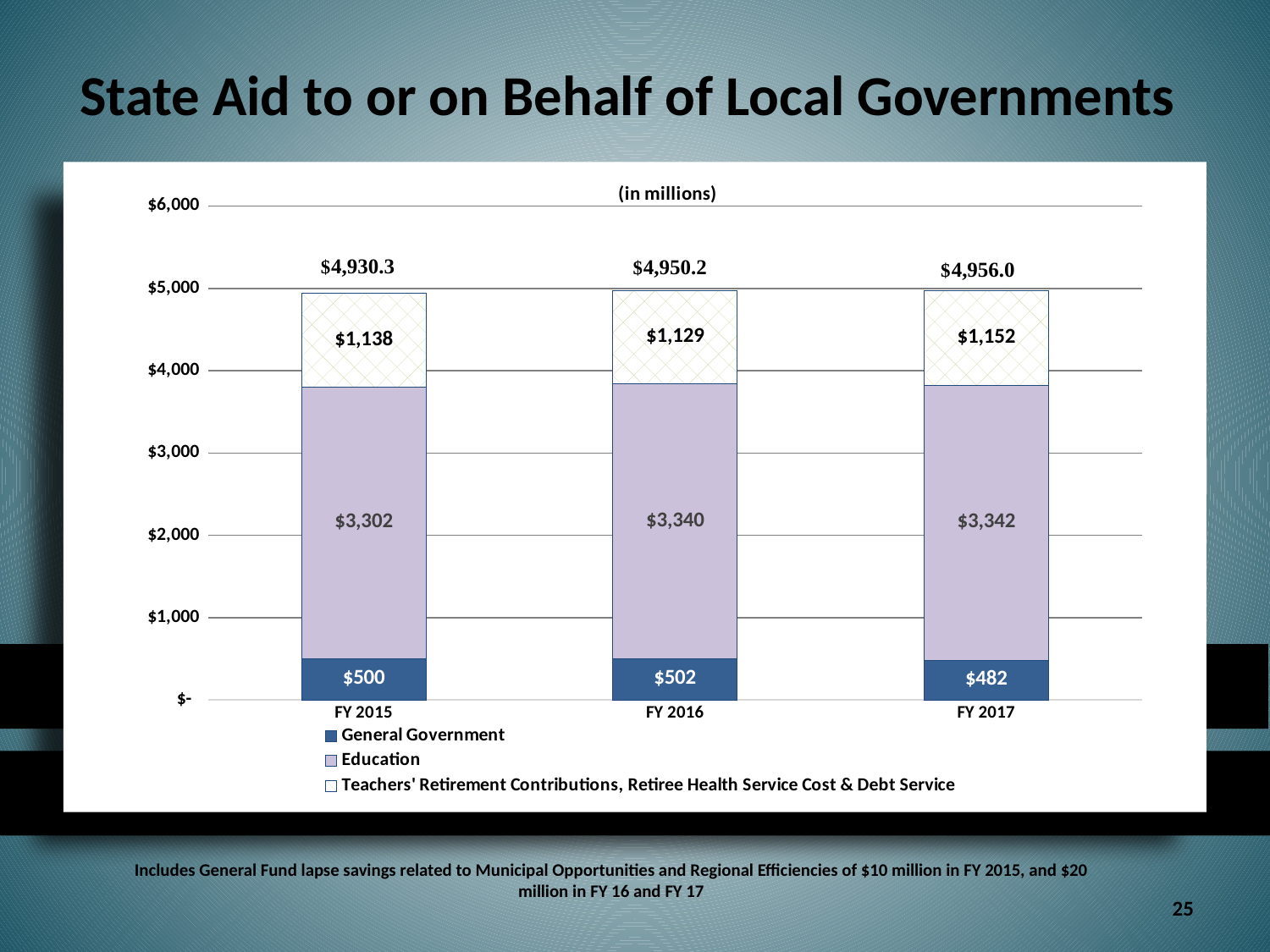
What kind of chart is shown on the slide? stacked bar chart Which fiscal year has the highest General Government value? FY 2016 Is the General Government value for FY 2015 larger or smaller than the General Government value for FY 2017? larger What is the General Government value for FY 2017? $482 How many fiscal years are shown on the x axis? 3 What is the total of the stacked bar for FY 2017? $4,956.0 Which fiscal year has the lowest Teachers' Retirement Contributions, Retiree Health Service Cost & Debt Service value? FY 2016 What is the Education value for FY 2016? $3,340 What is the difference between the Education values for FY 2016 and FY 2015? $38 Do the bar totals rise or fall from FY 2015 to FY 2017? rise How many series does the legend list? 3 What is the value for Teachers' Retirement Contributions, Retiree Health Service Cost & Debt Service in FY 2015? $1,138